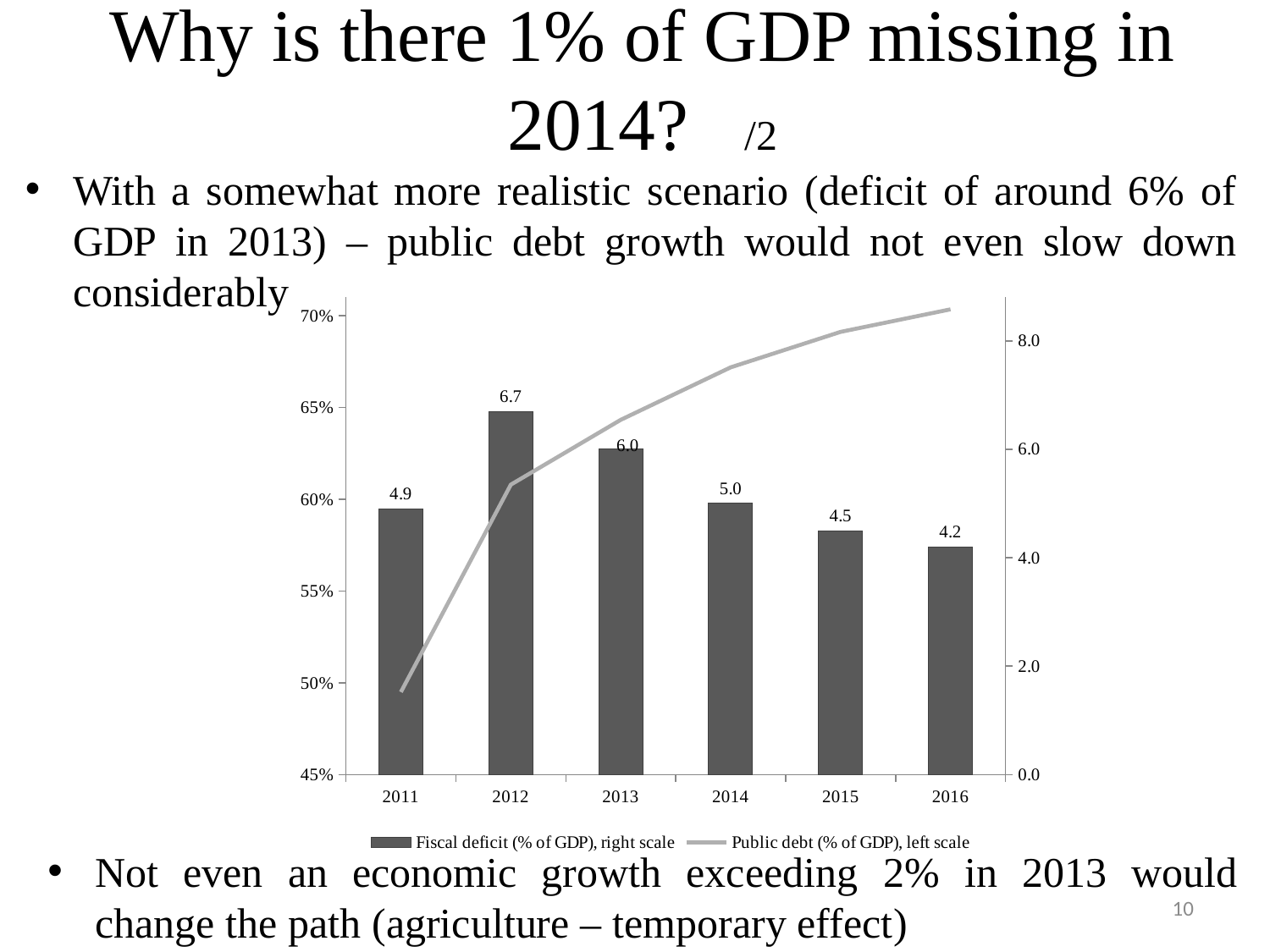
In which year is the fiscal deficit (% of GDP) highest? 2012 In which year is the fiscal deficit (% of GDP) lowest? 2016 Does the public debt (% of GDP) line rise or fall from 2011 to 2016? rise What is the fiscal deficit (% of GDP) value shown for 2016? 4.2 Which year has a larger fiscal deficit (% of GDP), 2011 or 2014? 2014 Which series is plotted against the right scale of the chart? Fiscal deficit (% of GDP) What is the difference between the fiscal deficit values for 2012 and 2013? 0.7 Is the public debt (% of GDP) value for 2016 greater or less than 65%? greater Is the public debt (% of GDP) value for 2011 greater or less than 55%? less How many years are shown on the x axis of the chart? 6 What is the fiscal deficit (% of GDP) value shown for 2012? 6.7 How many series does the chart legend list? 2